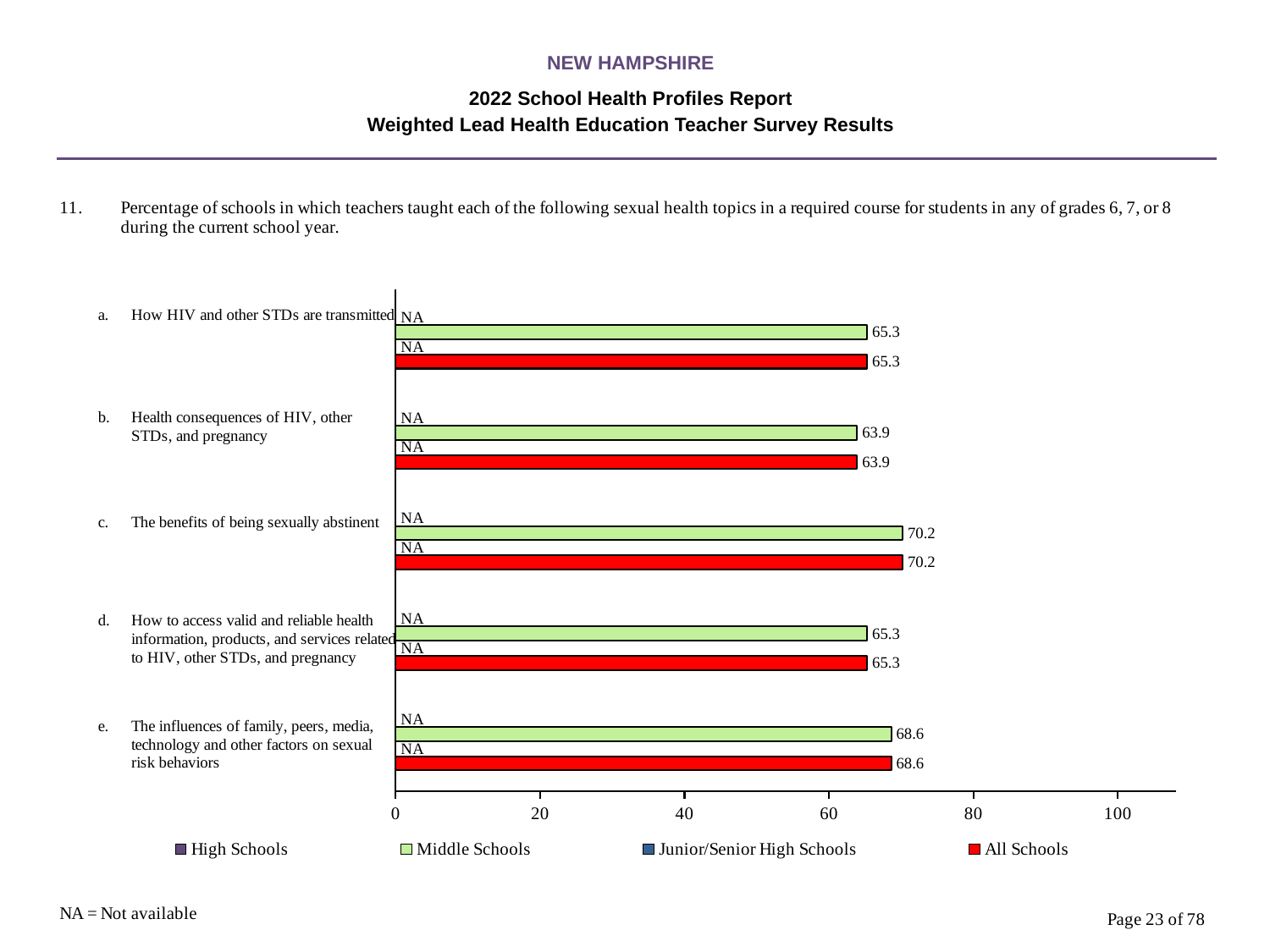
Which topic has the lowest All Schools value? Health consequences of HIV, other STDs, and pregnancy Which topic has the highest Middle Schools value? The benefits of being sexually abstinent What is the All Schools value for 'Health consequences of HIV, other STDs, and pregnancy'? 63.9 What is the difference between the Middle Schools values for 'The benefits of being sexually abstinent' and 'Health consequences of HIV, other STDs, and pregnancy'? 6.3 What is the Middle Schools value for 'The influences of family, peers, media, technology and other factors on sexual risk behaviors'? 68.6 How many series does the legend list? 4 What is the Middle Schools value for 'The benefits of being sexually abstinent'? 70.2 How many topics (categories) are shown in the chart? 5 What kind of chart is shown on the slide? Bar chart What is the High Schools value for 'How HIV and other STDs are transmitted'? NA Is the Middle Schools value for 'How to access valid and reliable health information, products, and services related to HIV, other STDs, and pregnancy' greater or less than 60? greater Which is larger: the All Schools value for 'The influences of family, peers, media, technology and other factors on sexual risk behaviors' or for 'How HIV and other STDs are transmitted'? The influences of family, peers, media, technology and other factors on sexual risk behaviors